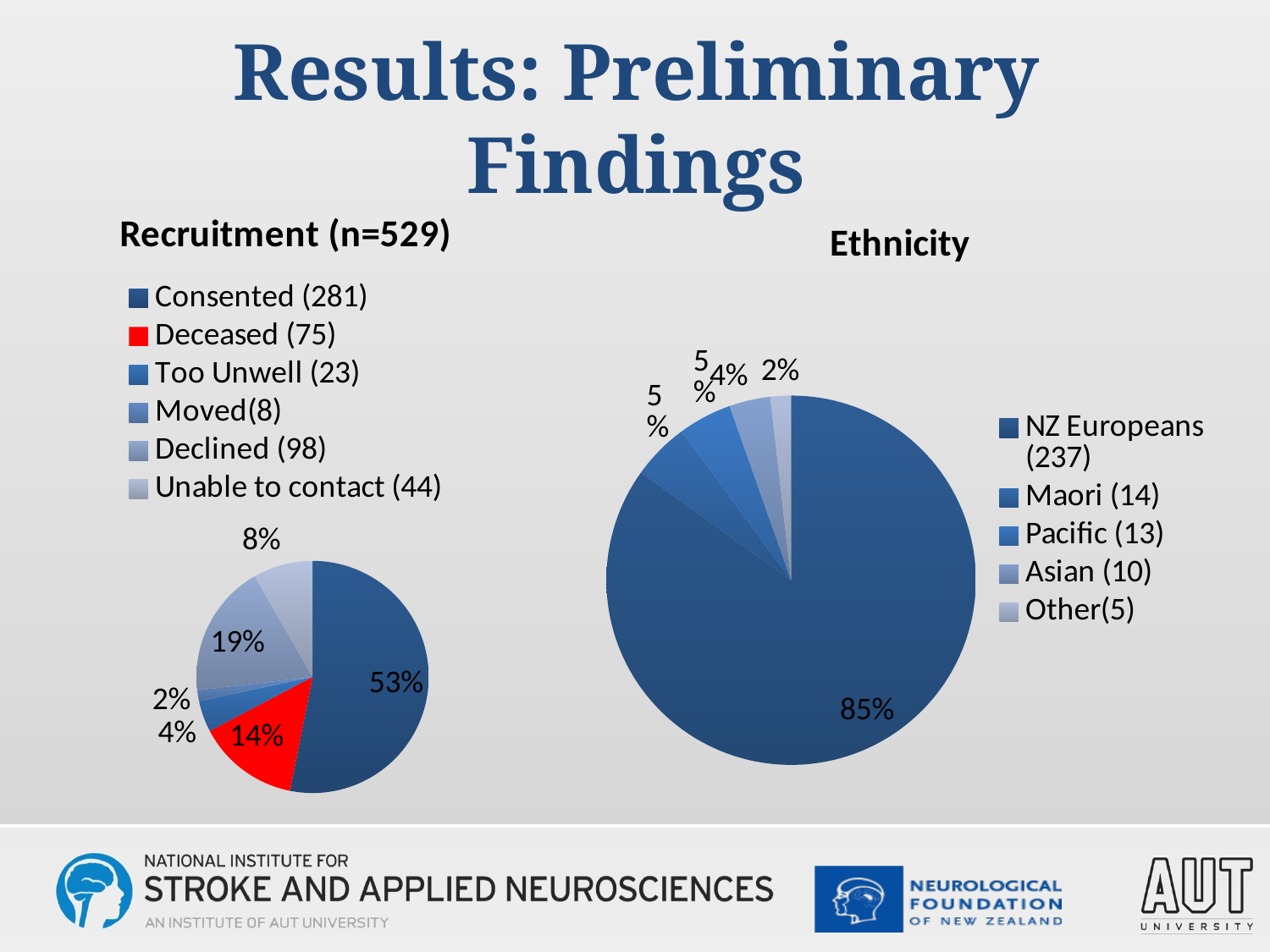
In the Ethnicity chart, what share of the pie is NZ Europeans? 85% In the Recruitment (n=529) chart, what share of the pie is Consented? 53% In the Ethnicity chart, which category has the largest slice? NZ Europeans In the Recruitment (n=529) chart, how many people are listed as Unable to contact in the legend? 44 In the Recruitment (n=529) chart, what is the difference in percentage points between the Declined and Unable to contact slices? 11% In the Recruitment (n=529) chart, which category has the smallest slice? Moved In the Ethnicity chart, how many people are listed as Maori in the legend? 14 In the Recruitment (n=529) chart, what share of the pie is Declined? 19% In the Ethnicity chart, how many categories does the legend list? 5 What type of chart is the Ethnicity chart? Pie chart In the Recruitment (n=529) chart, how many categories does the legend list? 6